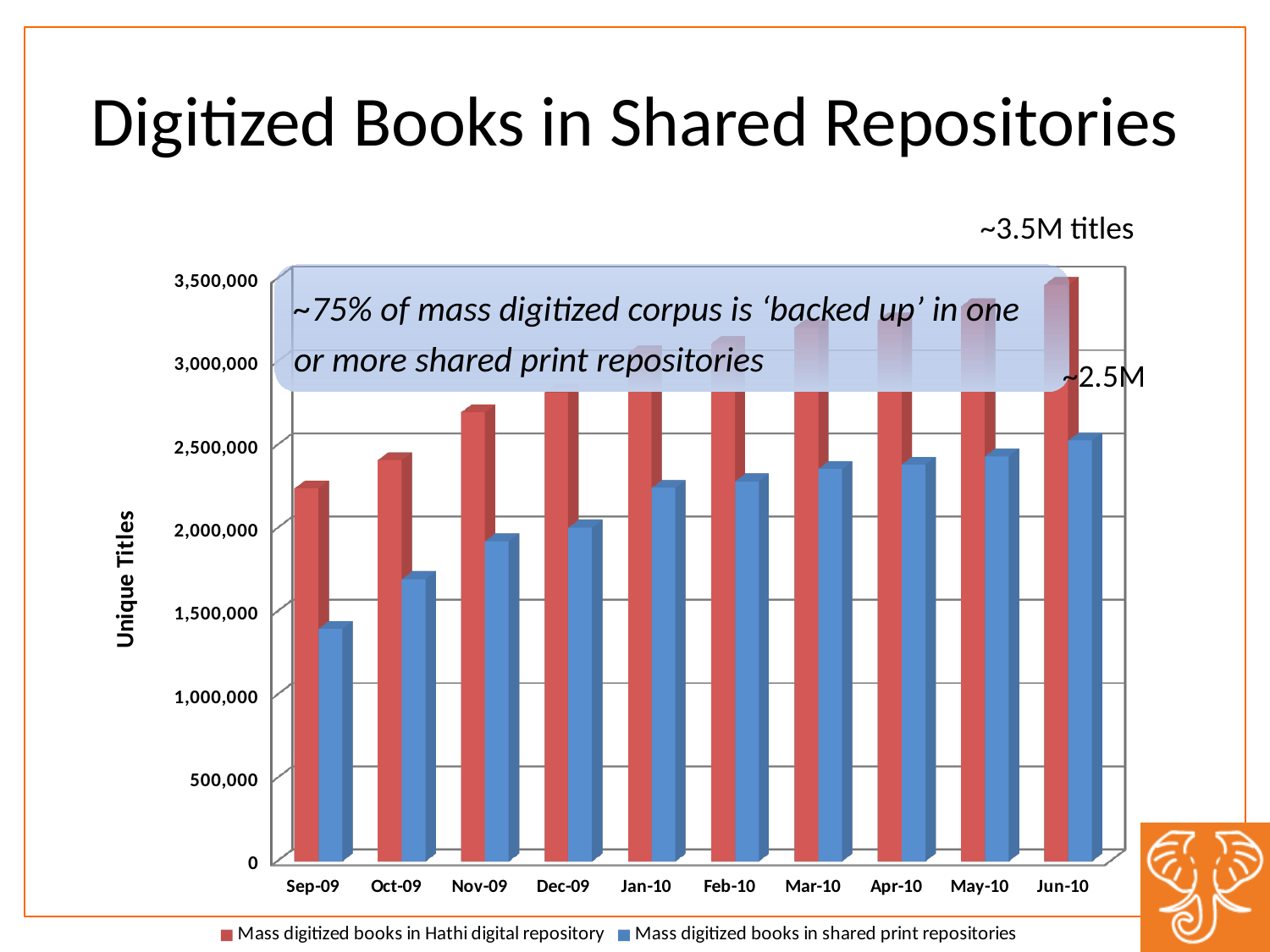
Is the value for mass digitized books in shared print repositories in Sep-09 greater or less than 1,500,000? less Do the values for mass digitized books in shared print repositories rise or fall from Sep-09 to Jun-10? Rise Is the value for mass digitized books in Hathi digital repository in Nov-09 greater or less than 2,500,000? greater In Sep-09, which is larger: mass digitized books in Hathi digital repository or mass digitized books in shared print repositories? Mass digitized books in Hathi digital repository What is the label on the vertical axis of the chart? Unique Titles Is the value for mass digitized books in shared print repositories in Apr-10 greater or less than 2,500,000? less What kind of chart is shown on the slide? Bar chart How many series does the legend list? 2 In which month is the number of mass digitized books in shared print repositories lowest? Sep-09 How many months are shown along the x axis? 10 In which month is the number of mass digitized books in Hathi digital repository highest? Jun-10